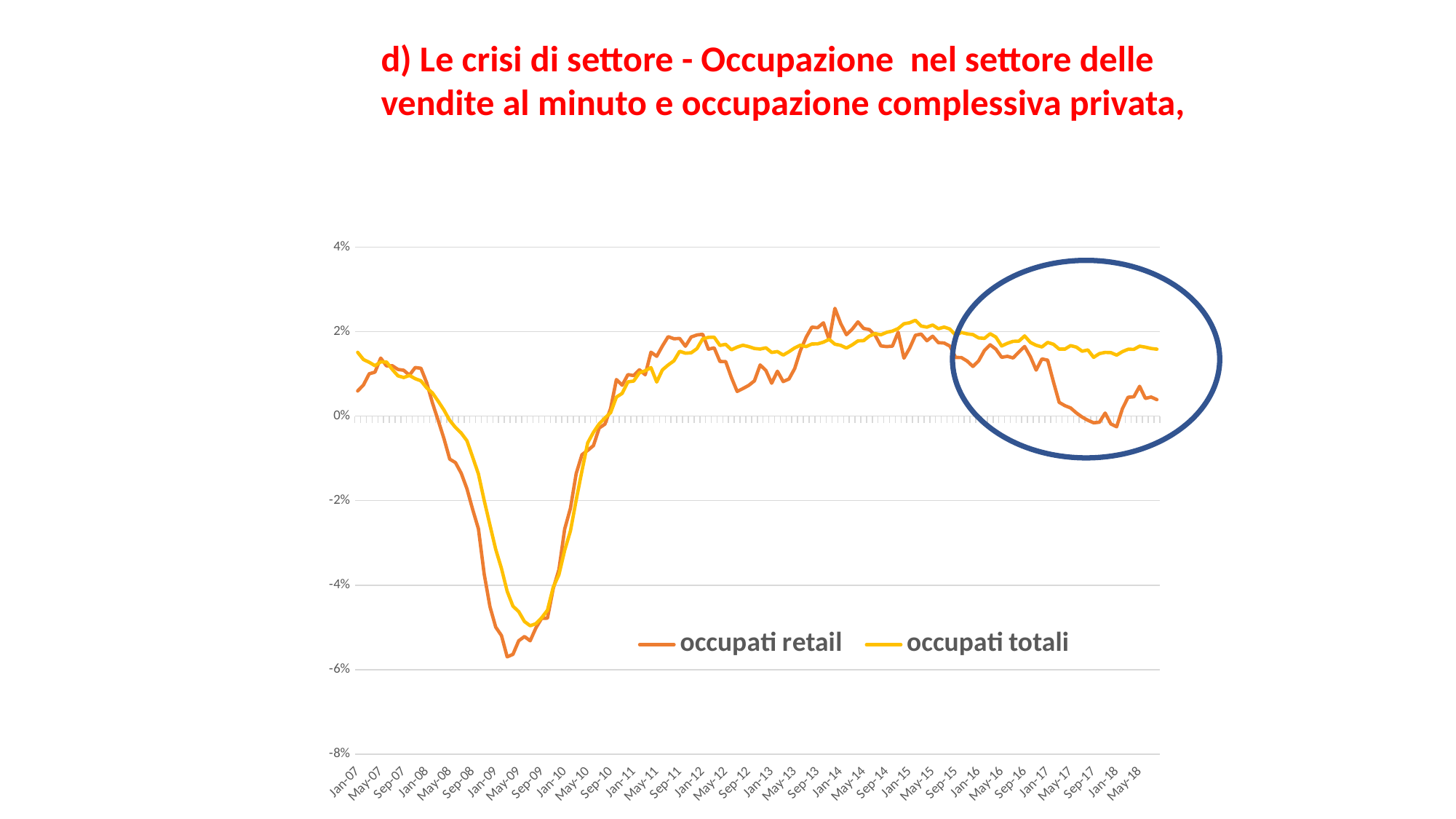
What are the two series named in the legend? occupati retail, occupati totali Between Jan-16 and Sep-17, does the occupati retail line rise or fall? fall How many series does the legend list? 2 At Jan-14, which series has the higher value, occupati retail or occupati totali? occupati retail Is the value for occupati retail at May-09 greater or less than -4%? less At Sep-17, which series has the higher value, occupati retail or occupati totali? occupati totali What kind of chart is shown on the slide? line chart Which series reaches the lowest value anywhere on the chart? occupati retail Is the value for occupati totali at Jan-18 greater or less than 0%? greater What colour is the line for occupati totali? yellow Is the value for occupati totali at May-09 greater or less than -4%? less